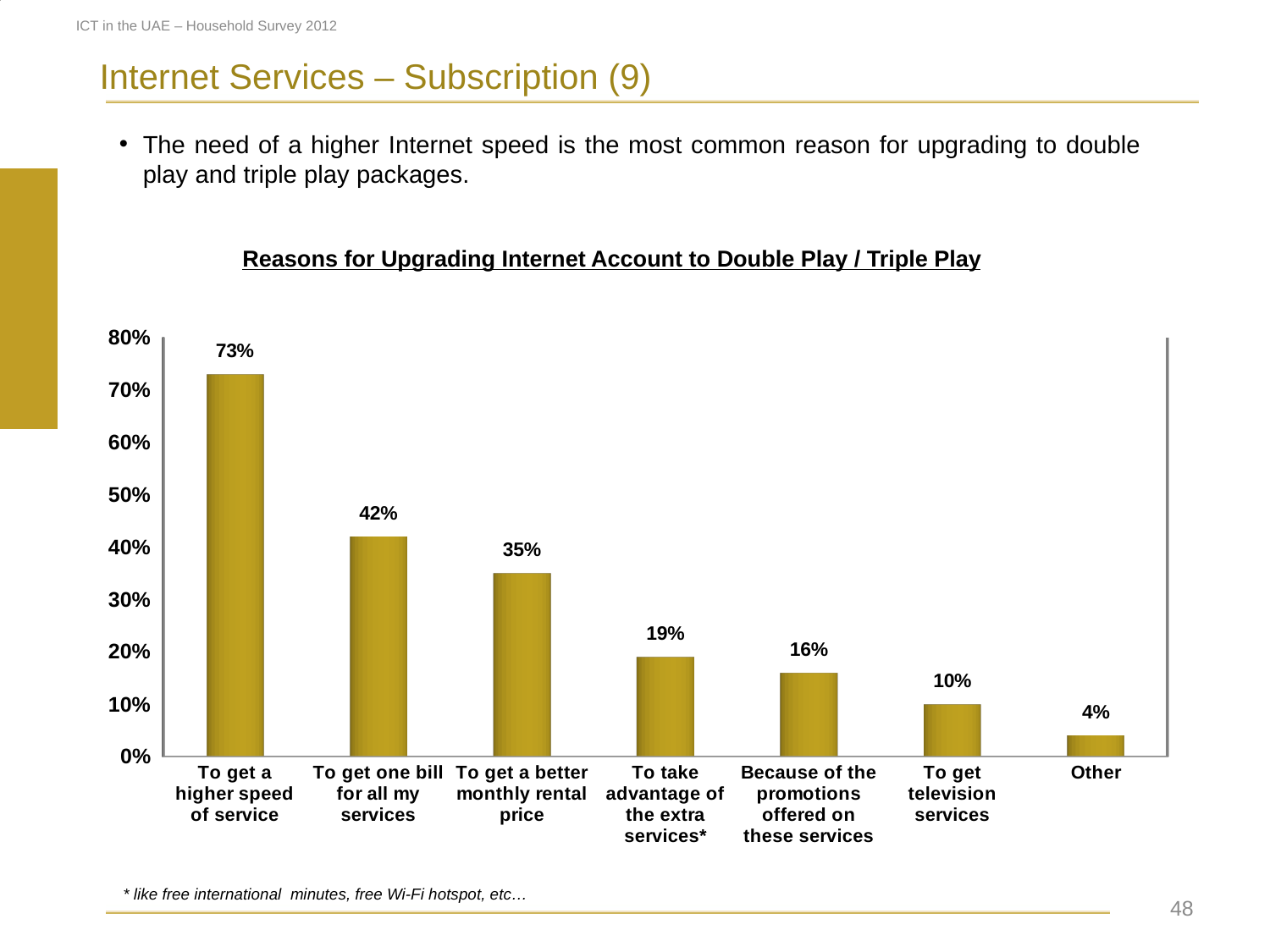
How many reasons (categories) are shown in the chart? 7 Which reason for upgrading has the highest percentage? To get a higher speed of service What percentage of respondents upgraded to get a higher speed of service? 73% What is the value shown for 'Other'? 4% What type of chart is used to show the reasons for upgrading? Bar chart Which reason for upgrading has the lowest percentage? Other Which is larger: 'To get a better monthly rental price' or 'To take advantage of the extra services*'? To get a better monthly rental price What is the difference between 'To get a higher speed of service' and 'To get one bill for all my services'? 31% What is the value for 'To get one bill for all my services'? 42% What percentage cited 'To get television services' as a reason for upgrading? 10% What is the difference between 'To take advantage of the extra services*' and 'Because of the promotions offered on these services'? 3% What is the title of the chart? Reasons for Upgrading Internet Account to Double Play / Triple Play